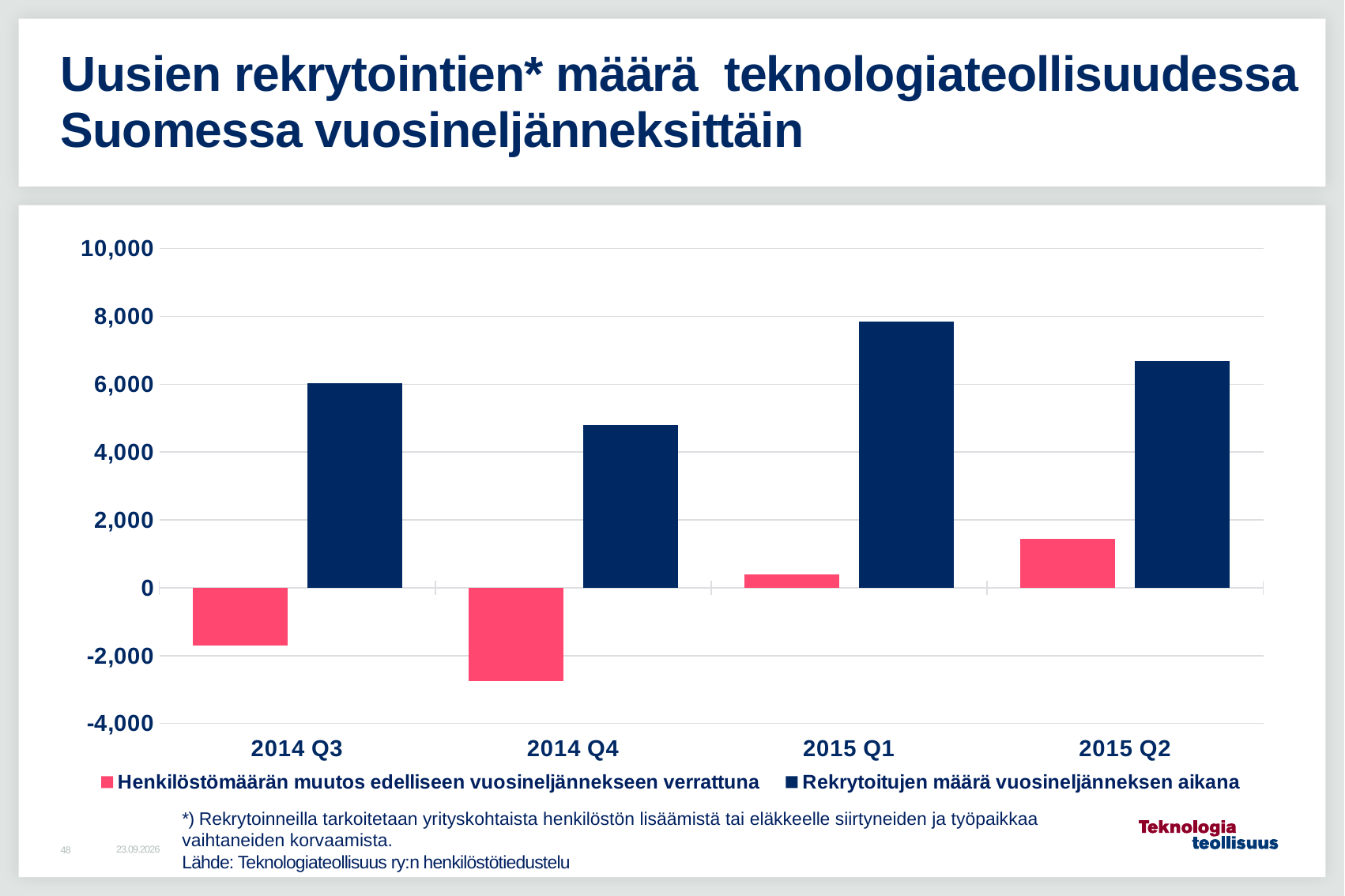
In which quarter is the value for 'Henkilöstömäärän muutos edelliseen vuosineljännekseen verrattuna' lowest? 2014 Q4 In which quarter is the value for 'Henkilöstömäärän muutos edelliseen vuosineljännekseen verrattuna' highest? 2015 Q2 In which quarter is the value for 'Rekrytoitujen määrä vuosineljänneksen aikana' highest? 2015 Q1 What kind of chart is shown on the slide? bar chart Is the value for 'Rekrytoitujen määrä vuosineljänneksen aikana' in 2015 Q1 greater or less than 6,000? greater How many quarters are shown on the x axis? 4 Is the value for 'Henkilöstömäärän muutos edelliseen vuosineljännekseen verrattuna' in 2014 Q4 greater or less than -2,000? less Which colour represents 'Rekrytoitujen määrä vuosineljänneksen aikana' in the legend? dark blue Does the value for 'Henkilöstömäärän muutos edelliseen vuosineljännekseen verrattuna' rise or fall from 2014 Q4 to 2015 Q2? rise In which quarter is the value for 'Rekrytoitujen määrä vuosineljänneksen aikana' lowest? 2014 Q4 Which is larger: the value for 'Rekrytoitujen määrä vuosineljänneksen aikana' in 2015 Q2 or in 2014 Q4? 2015 Q2 How many series does the legend list? 2